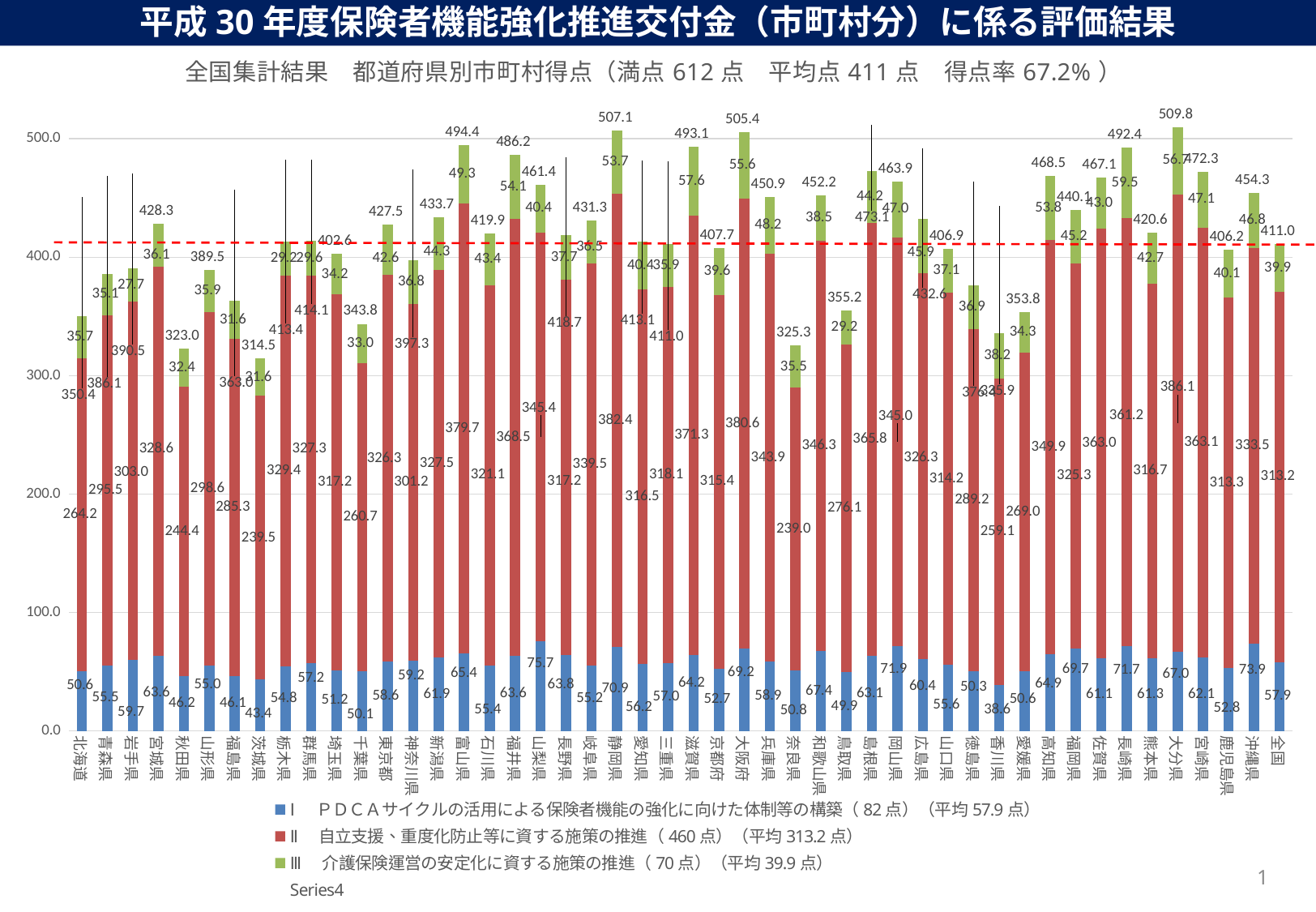
What is the value of the green segment (Ⅲ) for 長崎県? 59.5 Which prefecture has the lowest total score? 茨城県 What is the value of the red segment (Ⅱ) for 大分県? 386.1 What kind of chart is shown on the slide? stacked bar chart What is the total score shown for 静岡県? 507.1 How many categories (bars) are plotted along the x axis? 48 Which has the higher total score, 富山県 or 福井県? 富山県 Is the total score for 秋田県 greater or less than 400.0? less Which prefecture has the highest total score? 大分県 What is the difference between the total score of 大分県 and that of 茨城県? 195.3 What is the total score shown for 全国? 411.0 What is the value of the blue segment (Ⅰ) for 山梨県? 75.7